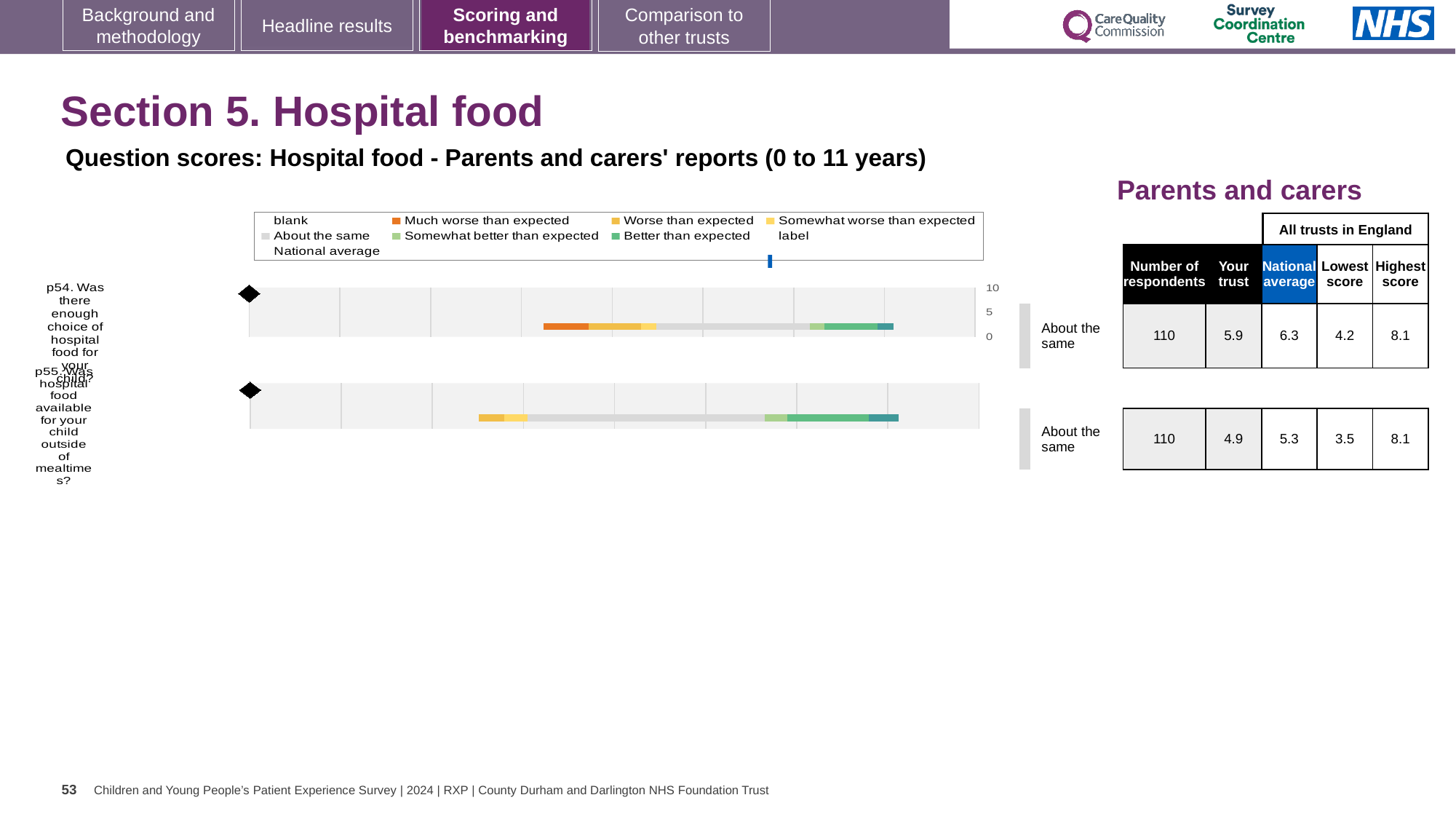
What benchmark category is shown for p55? About the same What is the national average score for p55 (Was hospital food available for your child outside of mealtimes?)? 5.3 Which question has the higher 'Your trust' score, p54 or p55? p54 What is the difference between the highest and lowest scores for p55? 4.6 What is the highest score across all trusts in England for p54? 8.1 How many respondents answered p54? 110 How many questions are plotted on the chart? 2 What is the 'Your trust' score for p54 (Was there enough choice of hospital food for your child?)? 5.9 Is the 'Your trust' score for p55 greater or less than 5? less What kind of chart is used to show the question scores? Bar chart What is the lowest score across all trusts in England for p55? 3.5 What is the difference between the national average and the 'Your trust' score for p54? 0.4